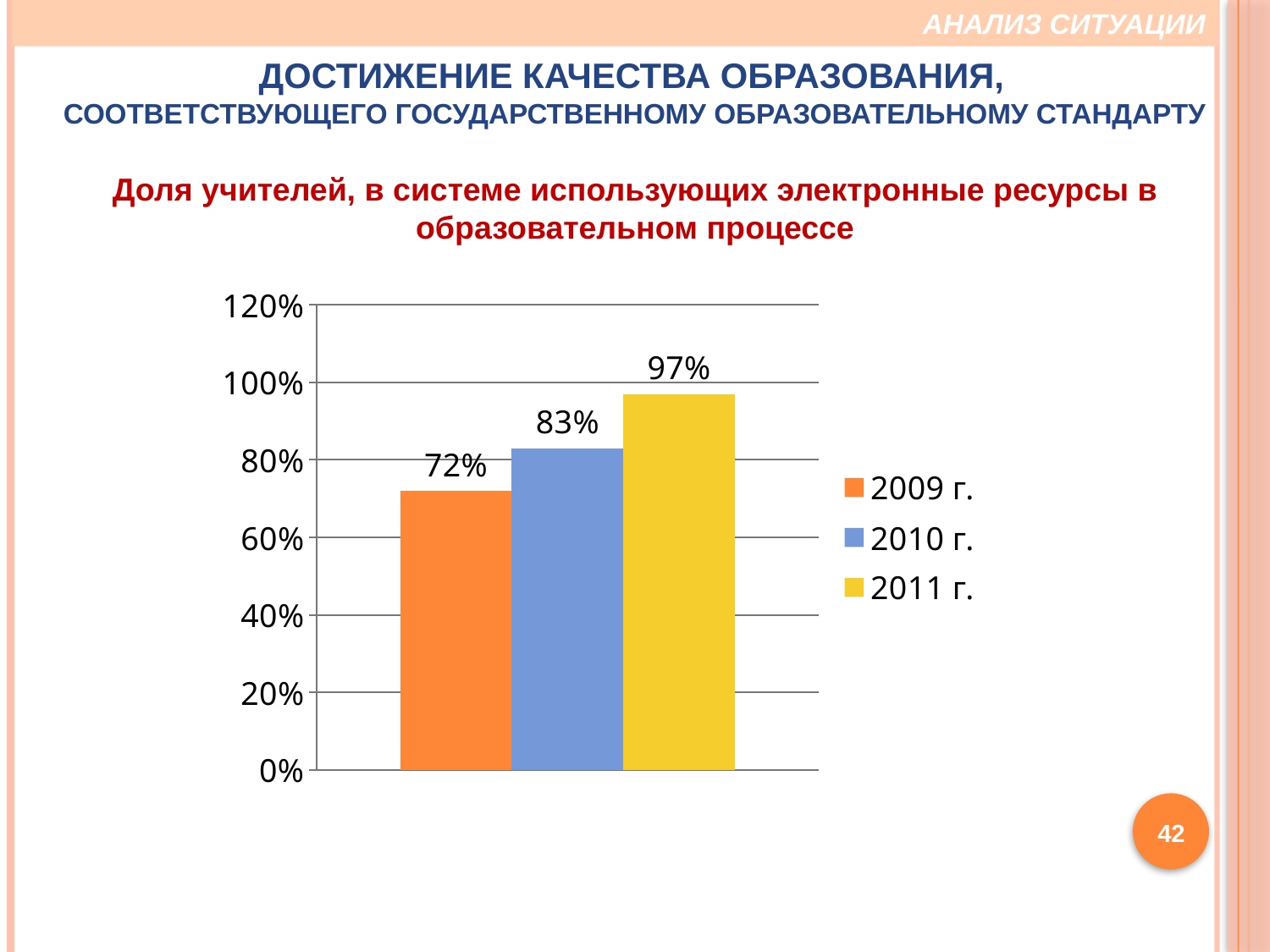
What is the value for 2011 г.? 97% What is the difference between the values for 2011 г. and 2009 г.? 25% What is the difference between the values for 2010 г. and 2009 г.? 11% What kind of chart is shown on the slide? bar chart Is the value for 2009 г. greater or less than 80%? less What is the value for 2010 г.? 83% What is the value for 2009 г.? 72% Which year has the highest value? 2011 г. Which is larger, the value for 2010 г. or the value for 2011 г.? 2011 г. Do the values rise or fall from 2009 г. to 2011 г.? rise How many series does the legend list? 3 Which year has the lowest value? 2009 г.